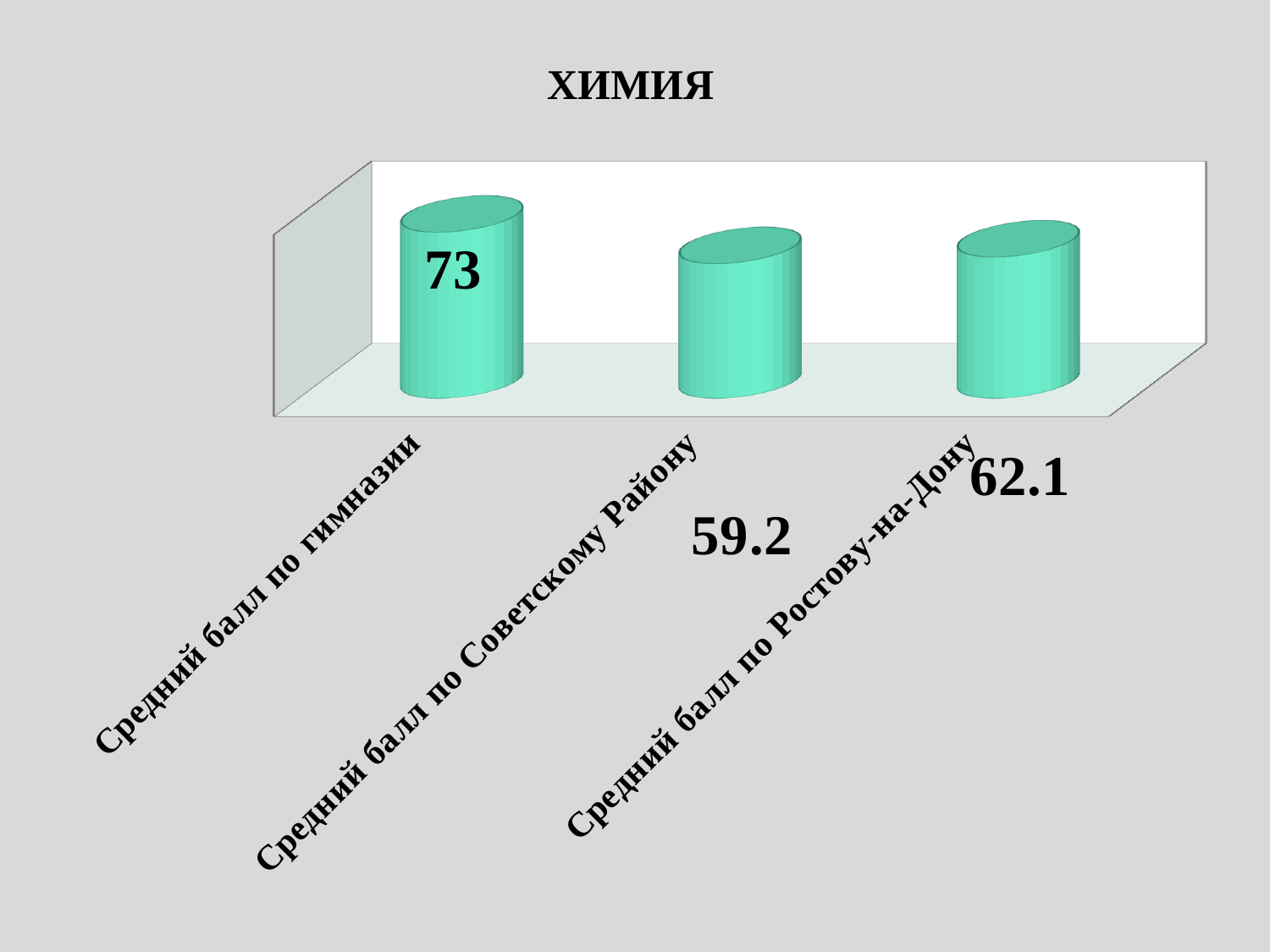
What kind of chart is shown on the slide? bar chart How many categories are shown in the chart? 3 What is the difference between the value for "Средний балл по гимназии" and the value for "Средний балл по Советскому Району"? 13.8 Which category has the highest value? Средний балл по гимназии Which is larger: the value for "Средний балл по Ростову-на-Дону" or the value for "Средний балл по Советскому Району"? Средний балл по Ростову-на-Дону What is the value for "Средний балл по гимназии"? 73 What colour are the bars in the chart? teal (turquoise) What is the difference between the value for "Средний балл по Ростову-на-Дону" and the value for "Средний балл по Советскому Району"? 2.9 What is the title of the chart? ХИМИЯ What is the value for "Средний балл по Ростову-на-Дону"? 62.1 What is the value for "Средний балл по Советскому Району"? 59.2 Which category has the lowest value? Средний балл по Советскому Району